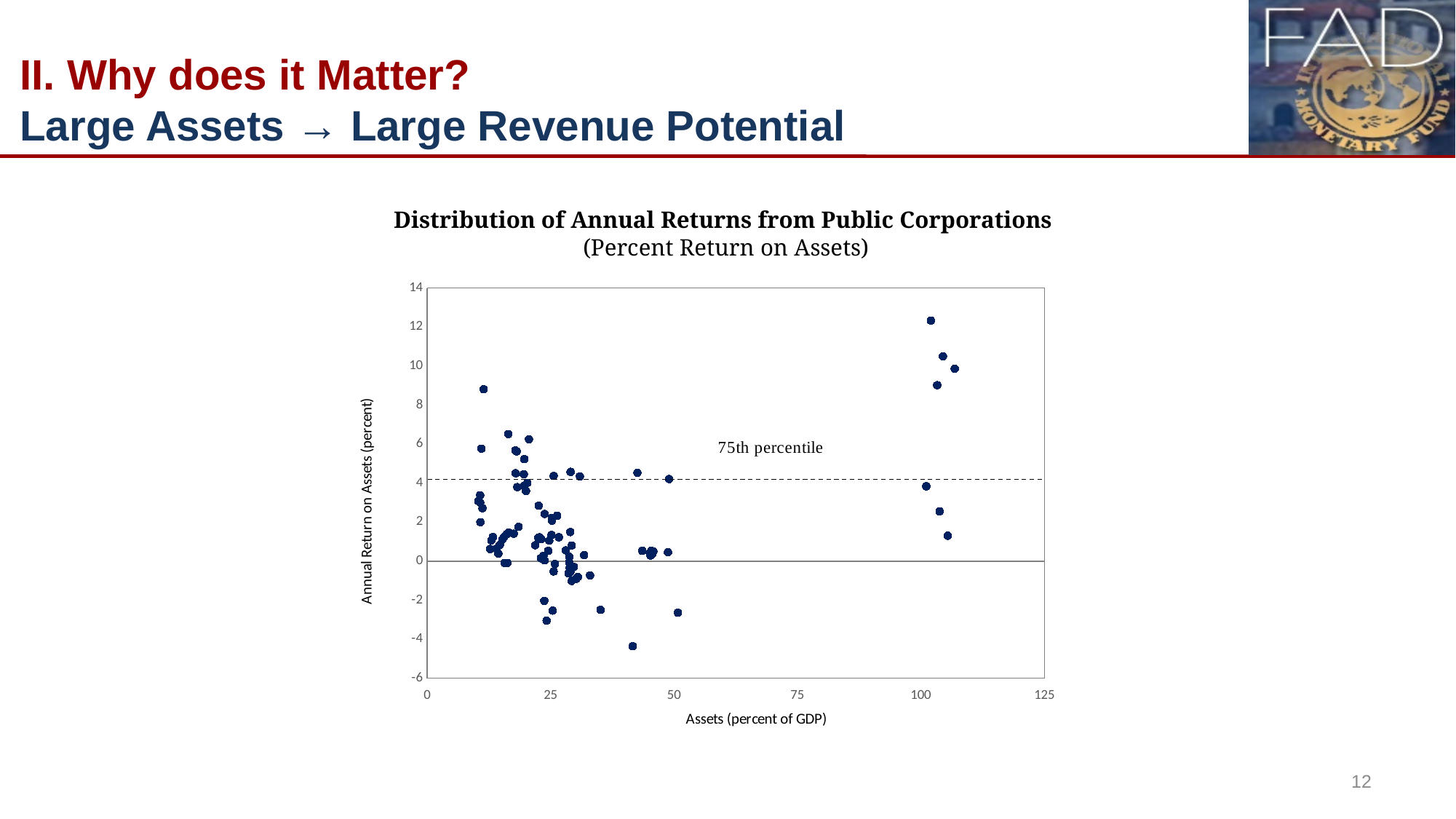
What is the title of the chart? Distribution of Annual Returns from Public Corporations Is the point with the lowest return located at assets greater or less than 50 percent of GDP? less Is the lowest plotted annual return on assets greater or less than -2? less What kind of chart is shown on the slide? Scatter chart Is the point with the largest assets (percent of GDP) greater or less than 100 on the x axis? greater Are the points with assets above 100 percent of GDP mostly above or below the 75th percentile line? above What does the dashed horizontal line in the chart represent? 75th percentile